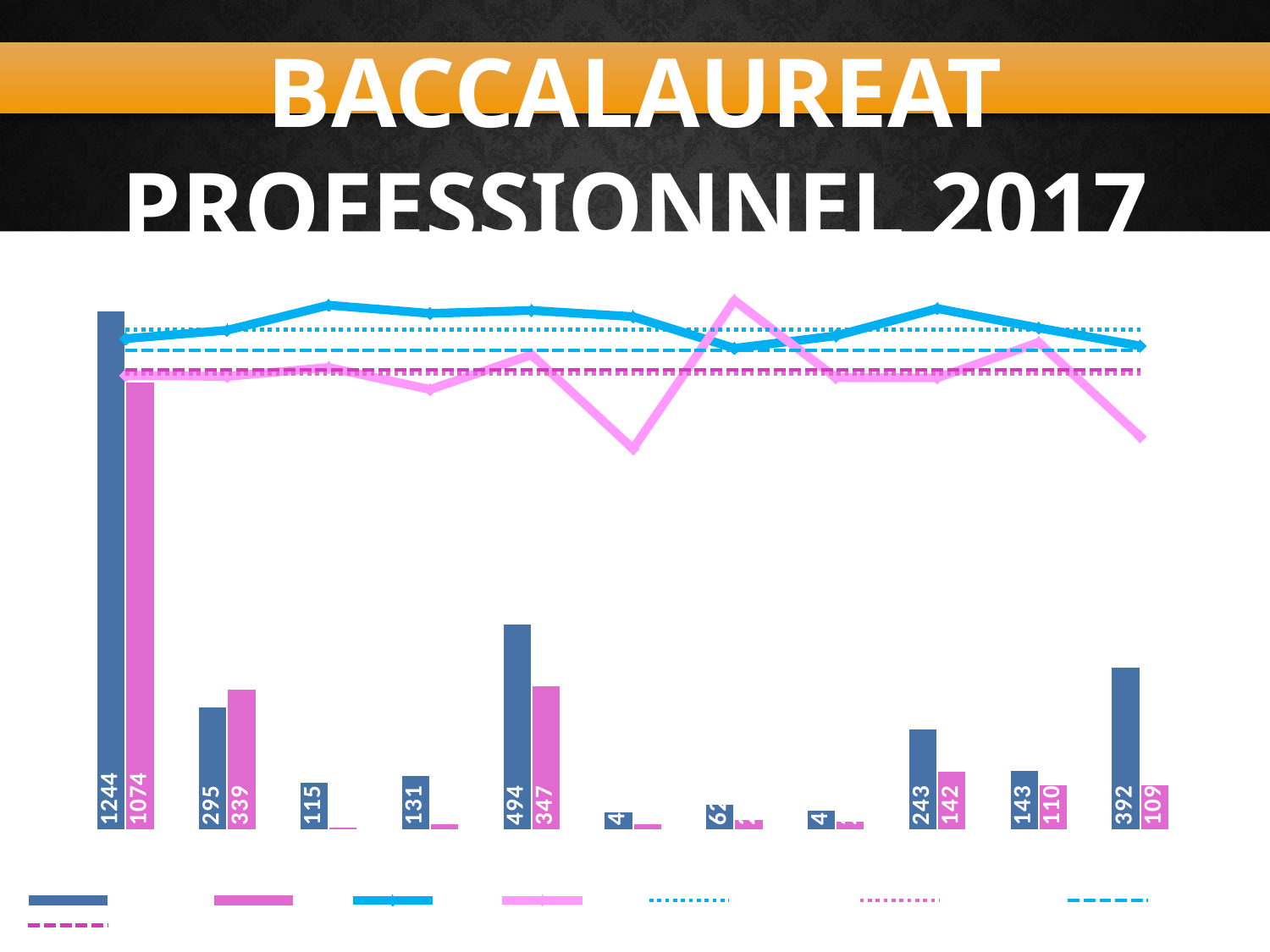
Which group has the tallest blue bar? The first (leftmost) group What is the value of the pink bar in the first (leftmost) group? 1074 How many groups of bars are plotted along the x axis? 11 What is the value of the blue bar in the last (rightmost) group? 392 What is the difference between the blue bar (392) and the pink bar (109) in the last group? 283 What is the difference between the blue bar (1244) and the pink bar (1074) in the first group? 170 What is the value of the pink bar in the last (rightmost) group? 109 What is the title of the slide containing the chart? BACCALAUREAT PROFESSIONNEL 2017 In the second group from the left, which bar is larger, the blue bar (295) or the pink bar (339)? The pink bar (339) What is the value of the blue bar in the first (leftmost) group? 1244 What kind of chart is shown on the slide? A combined bar and line chart What is the value of the blue bar in the fifth group from the left? 494